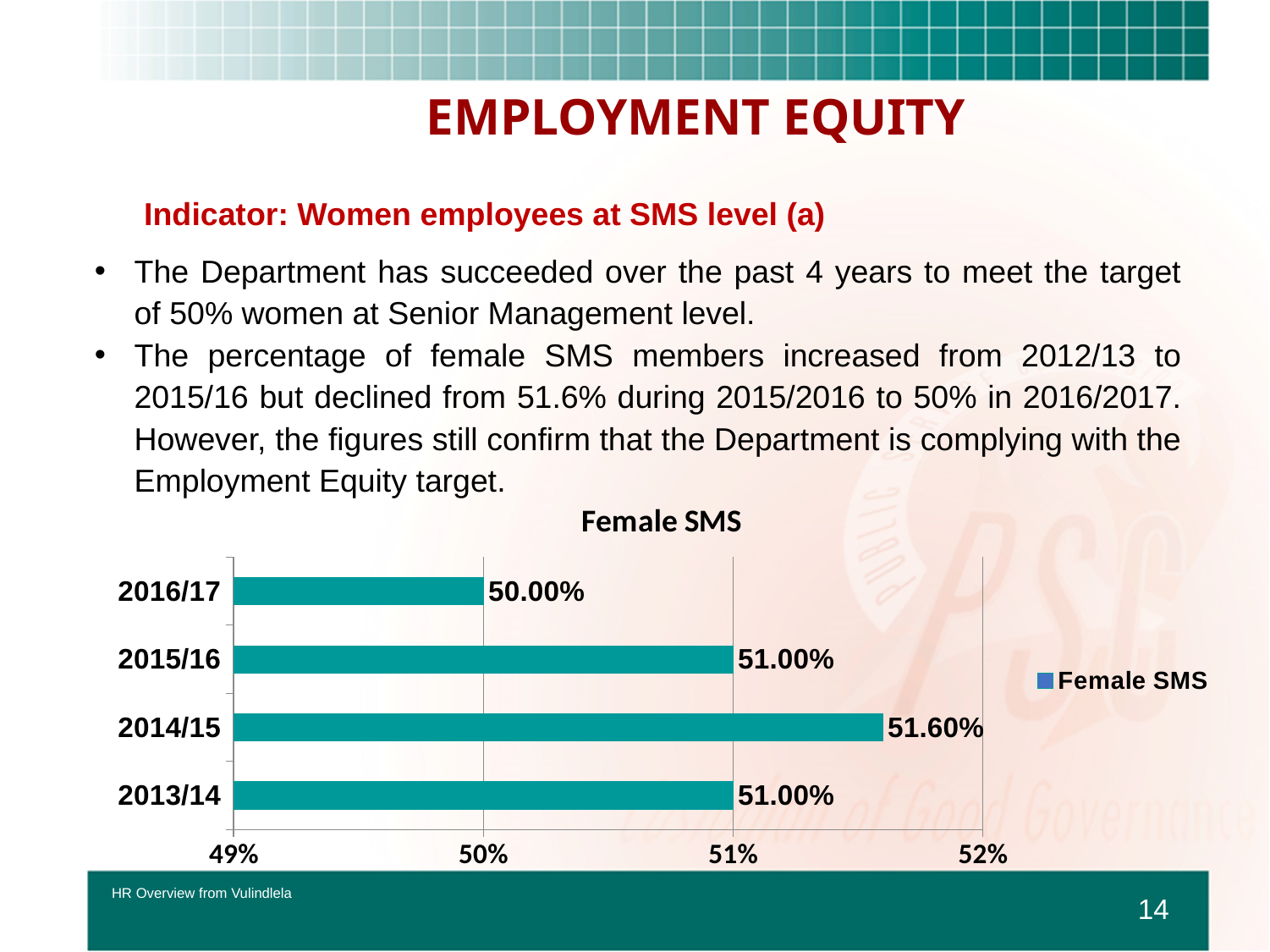
What is the value for 2014/15 in the Female SMS chart? 51.60% Did the value in the Female SMS chart rise or fall from 2014/15 to 2016/17? Fall What kind of chart is the Female SMS chart? Bar chart What is the value for 2013/14 in the Female SMS chart? 51.00% How many series does the legend of the Female SMS chart list? 1 Which is larger in the Female SMS chart, the value for 2015/16 or the value for 2016/17? 2015/16 Is the value for 2014/15 in the Female SMS chart greater or less than 51%? greater Which year has the highest value in the Female SMS chart? 2014/15 What is the difference between the values for 2014/15 and 2016/17 in the Female SMS chart? 1.60% How many years are shown in the Female SMS chart? 4 Which year has the lowest value in the Female SMS chart? 2016/17 What is the value for 2016/17 in the Female SMS chart? 50.00%